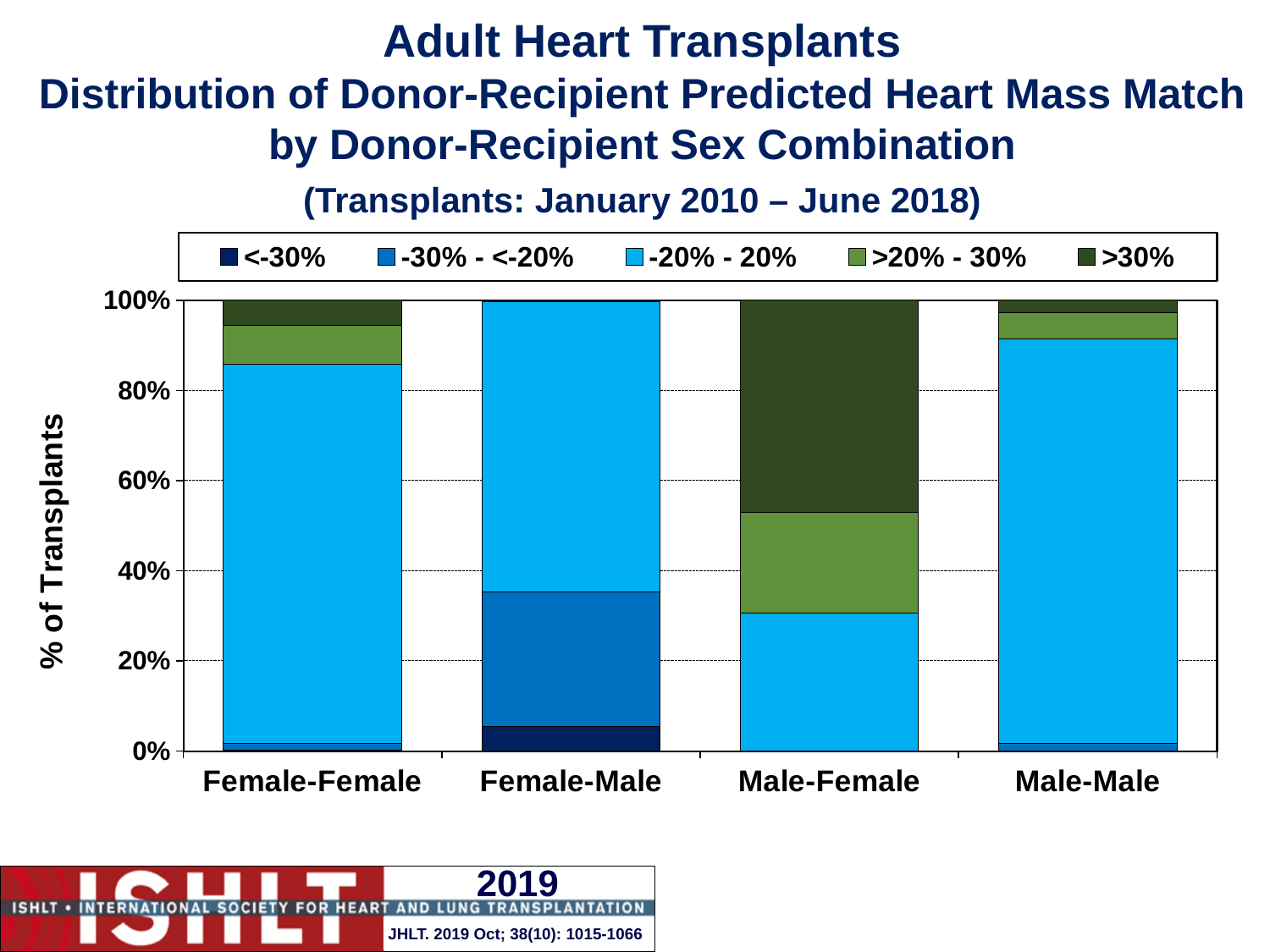
What is the label on the y axis? % of Transplants Is the >30% segment larger for Male-Female or for Female-Female? Male-Female How many donor-recipient sex combination categories are shown on the x axis? 4 Is the >30% share for Male-Female greater or less than 40%? greater What is the total height of each stacked bar? 100% How many series does the legend list? 5 Is the -20% - 20% share for Male-Female greater or less than 40%? less Which donor-recipient sex combination has the largest <-30% segment? Female-Male Which donor-recipient sex combination has the largest >30% segment? Male-Female Which donor-recipient sex combination has the smallest -20% - 20% segment? Male-Female What kind of chart is shown on the slide? Stacked bar chart Is the -20% - 20% share for Female-Male greater or less than 60%? greater